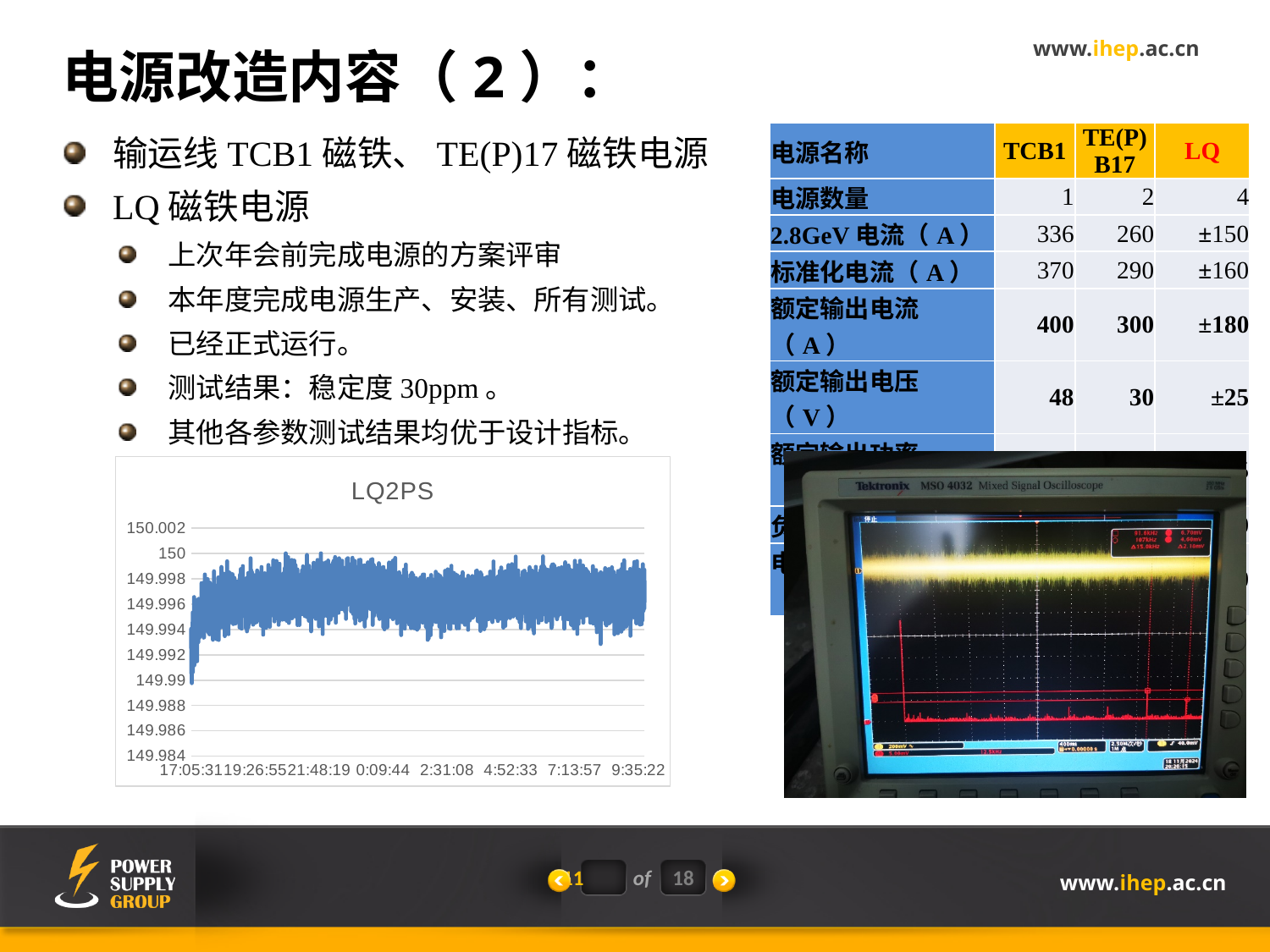
What kind of chart is the LQ2PS chart? line chart What is the lowest value shown on the y axis of the LQ2PS chart? 149.984 In the LQ2PS chart, is the plotted value at 2:31:08 greater or less than 150.002? less What colour is the plotted line in the LQ2PS chart? blue What is the highest value shown on the y axis of the LQ2PS chart? 150.002 In the LQ2PS chart, is the plotted value at 4:52:33 greater or less than 149.986? greater What is the first time label on the x axis of the LQ2PS chart? 17:05:31 How many time labels are shown along the x axis of the LQ2PS chart? 8 Does the plotted line in the LQ2PS chart show a strong rising trend, a strong falling trend, or stay roughly flat across the x axis? roughly flat What is the last time label on the x axis of the LQ2PS chart? 9:35:22 How many series are plotted in the LQ2PS chart? 1